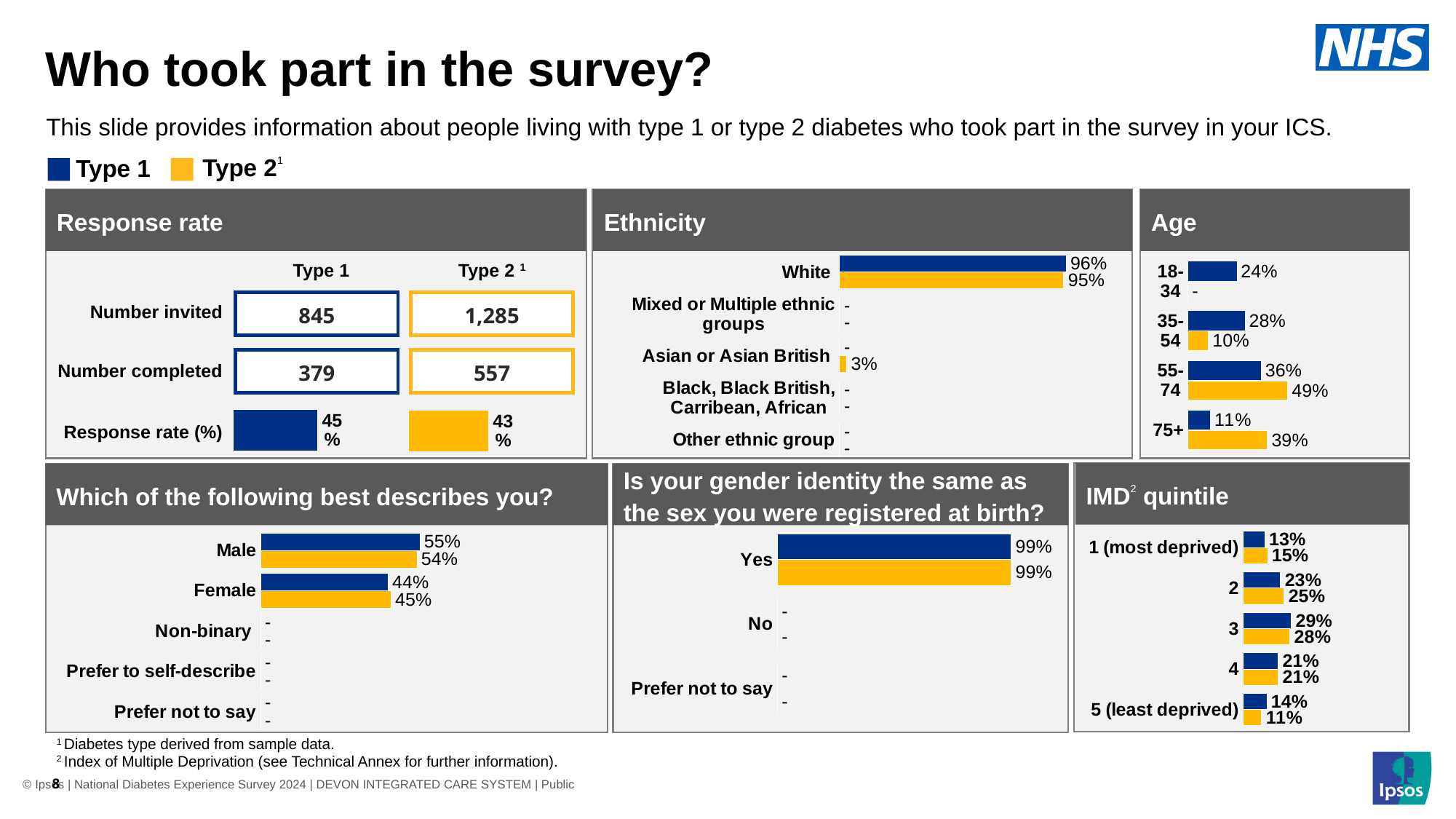
In the 'Which of the following best describes you?' chart, what percentage of Type 1 respondents are Male? 55% In the Response rate chart, what is the response rate for Type 2? 43% In the gender identity chart, what percentage of Type 2 respondents answered Yes? 99% In the IMD quintile chart, which quintile has the highest percentage of Type 1 respondents? 3 In the Ethnicity chart, what percentage of Type 2 respondents are Asian or Asian British? 3% In the 'Which of the following best describes you?' chart, is the Type 2 percentage for Female larger or smaller than the Type 1 percentage for Female? larger In the Ethnicity chart, what percentage of Type 1 respondents are White? 96% In the Response rate chart, what is the number of Type 1 respondents invited? 845 In the Age chart, which age group has the highest percentage of Type 2 respondents? 55-74 In the Age chart, what is the difference between the Type 2 and Type 1 percentages for the 75+ age group? 28 percentage points How many series does the legend at the top of the slide list? 2 In the Response rate chart, what is the difference between the number of Type 2 and Type 1 respondents who completed the survey? 178